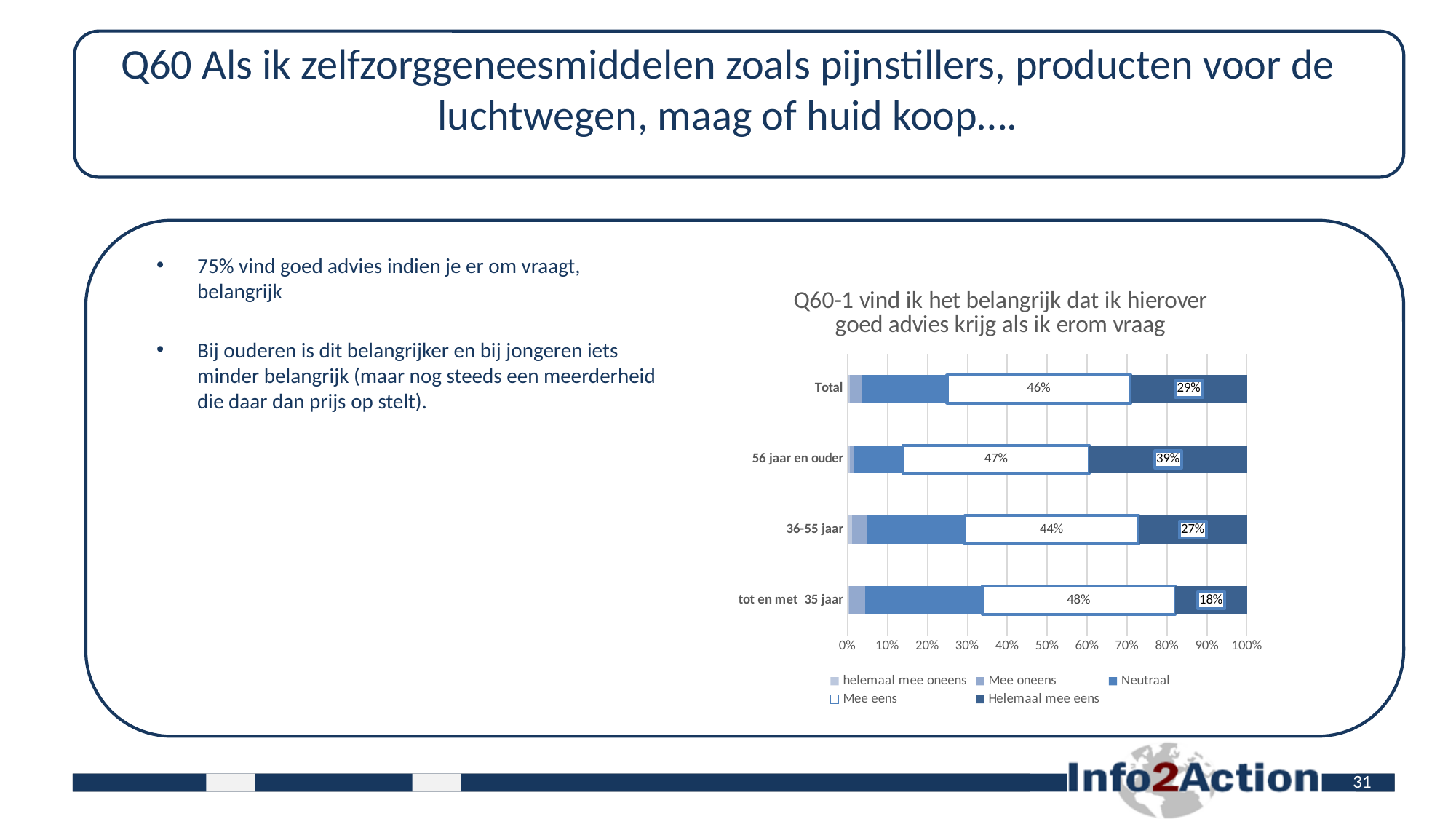
What is the value of "Helemaal mee eens" for tot en met 35 jaar? 18% How many series does the legend list? 5 What is the title of the chart? Q60-1 vind ik het belangrijk dat ik hierover goed advies krijg als ik erom vraag What is the value of "Helemaal mee eens" for 56 jaar en ouder? 39% What is the value of "Mee eens" for 36-55 jaar? 44% Which is larger: the "Mee eens" value for tot en met 35 jaar or for Total? tot en met 35 jaar What is the difference between the "Helemaal mee eens" values for 56 jaar en ouder and tot en met 35 jaar? 21% How many categories are shown on the chart? 4 Which category has the lowest value for "Mee eens"? 36-55 jaar What is the value of "Mee eens" for Total? 46% What kind of chart is shown on the slide? Stacked bar chart Which category has the highest value for "Helemaal mee eens"? 56 jaar en ouder